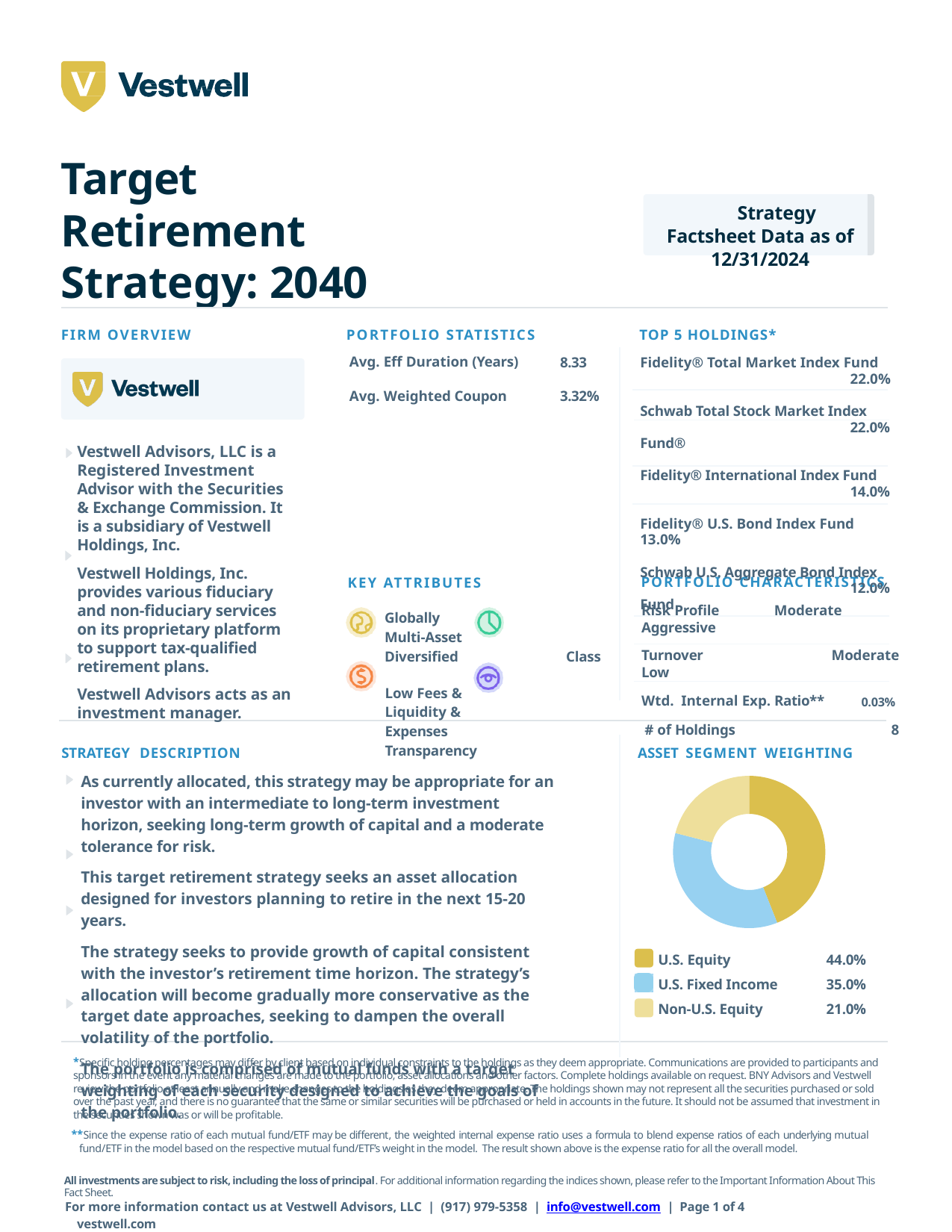
In the Asset Segment Weighting chart, what is the difference between the U.S. Fixed Income and Non-U.S. Equity weightings? 14.0% In the Asset Segment Weighting chart, what is the weighting for U.S. Equity? 44.0% What kind of chart is shown under Asset Segment Weighting? Pie chart (donut) In the Asset Segment Weighting chart, what is the weighting for Non-U.S. Equity? 21.0% In the Asset Segment Weighting chart, what is the weighting for U.S. Fixed Income? 35.0% What colour represents U.S. Fixed Income in the Asset Segment Weighting chart? Light blue In the Asset Segment Weighting chart, which is larger: U.S. Fixed Income or Non-U.S. Equity? U.S. Fixed Income What is the combined weighting of U.S. Equity and Non-U.S. Equity in the Asset Segment Weighting chart? 65.0% How many asset segments are shown in the Asset Segment Weighting chart? 3 Which asset segment has the smallest weighting in the Asset Segment Weighting chart? Non-U.S. Equity Which asset segment has the largest weighting in the Asset Segment Weighting chart? U.S. Equity In the Asset Segment Weighting chart, what is the difference between the U.S. Equity and U.S. Fixed Income weightings? 9.0%